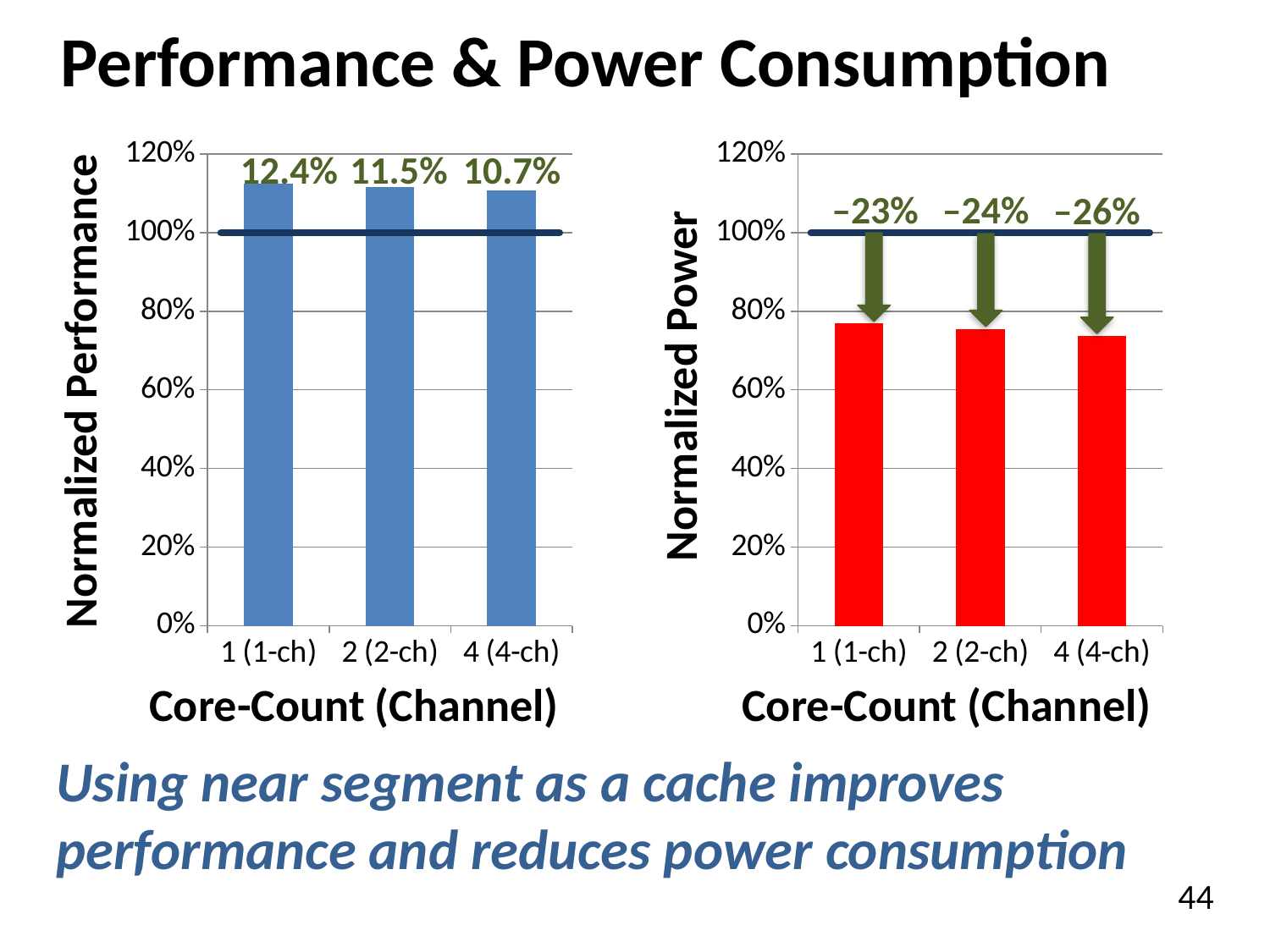
On the Normalized Performance chart (left), is the bar for 2 (2-ch) greater or less than 100%? greater On the Normalized Power chart (right), what reduction label is printed above the bar for 4 (4-ch)? –26% On the Normalized Performance chart (left), which core-count configuration has the highest bar? 1 (1-ch) What kind of chart is the Normalized Power chart (right)? Bar chart How many core-count configurations are shown on the x axis of the Normalized Performance chart (left)? 3 On the Normalized Power chart (right), which core-count configuration has the lowest bar? 4 (4-ch) On the Normalized Performance chart (left), what improvement label is printed above the bar for 4 (4-ch)? 10.7% On the Normalized Power chart (right), what reduction label is printed above the bar for 2 (2-ch)? –24% On the Normalized Power chart (right), which bar is taller, 1 (1-ch) or 4 (4-ch)? 1 (1-ch) On the Normalized Power chart (right), is the bar for 1 (1-ch) greater or less than 80%? less On the Normalized Power chart (right), do the bars rise or fall as the core count increases from 1 to 4? Fall On the Normalized Performance chart (left), what improvement label is printed above the bar for 1 (1-ch)? 12.4%